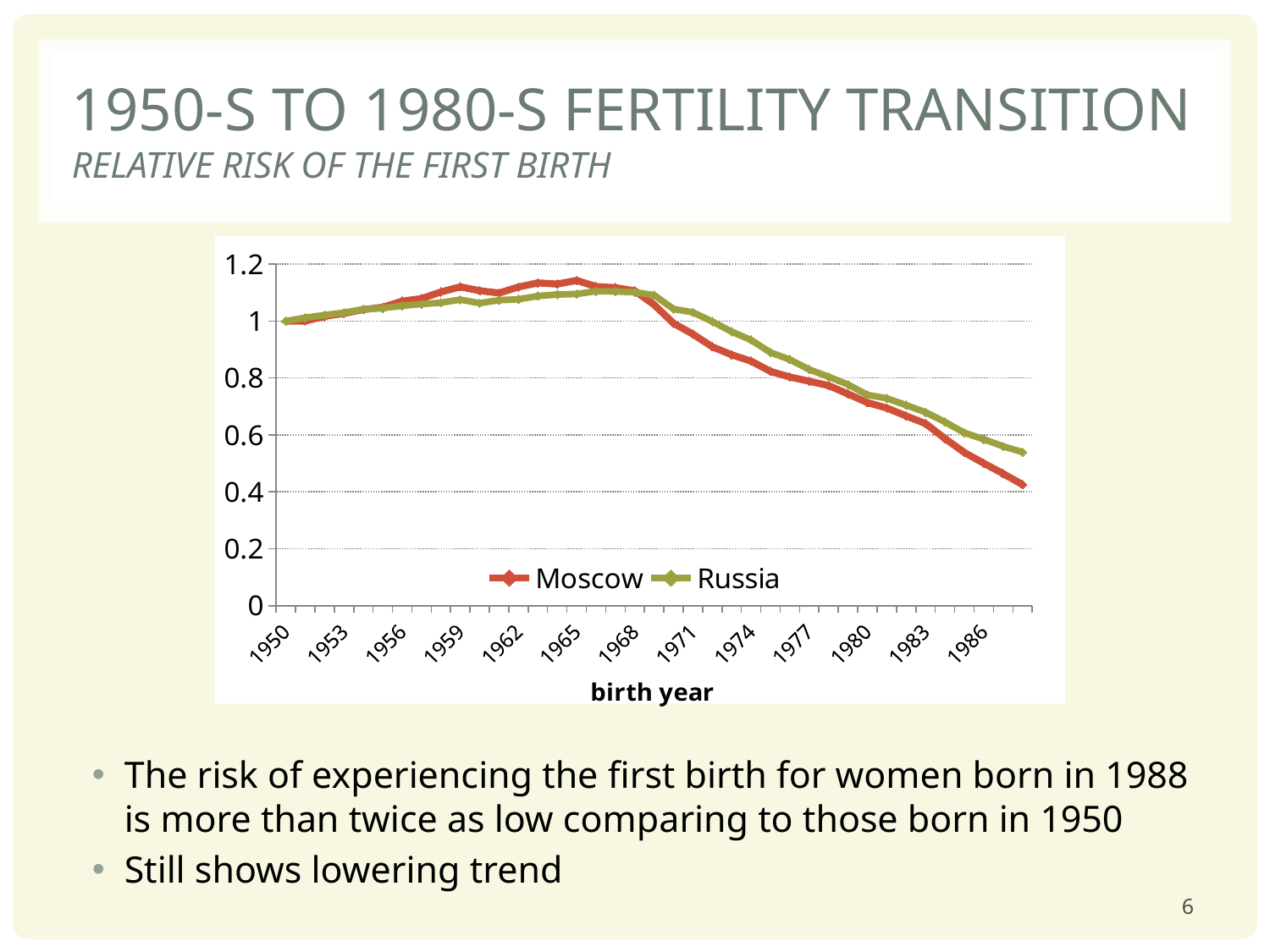
How many series does the chart legend list? 2 What is the title of the x axis of the chart? birth year Is the value for Moscow at birth year 1986 greater or less than 0.6? less For birth year 1980, which series has the higher value, Moscow or Russia? Russia Is the value for Moscow at birth year 1959 greater or less than 1? greater What type of chart is shown on the slide? line chart What is the value of the Moscow series for birth year 1950? 1 Do the values of both series rise or fall along the x axis after birth year 1968? fall For birth year 1986, which series has the higher value, Moscow or Russia? Russia Is the value for Russia at birth year 1974 greater or less than 0.8? greater What are the two series named in the chart legend? Moscow and Russia What is the value of the Russia series for birth year 1950? 1